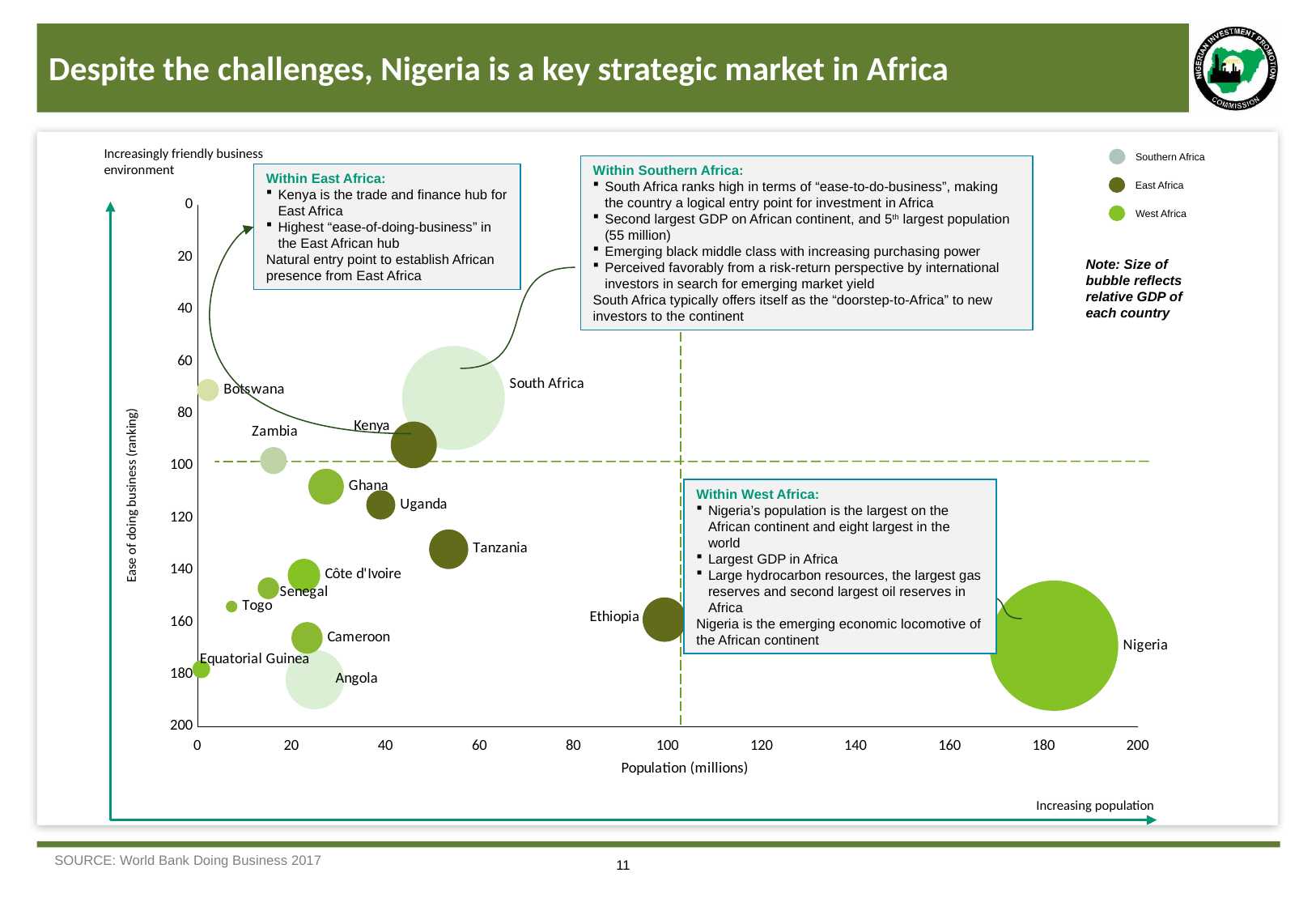
What does the size of each bubble represent according to the note? Relative GDP of each country What kind of chart is shown on the slide? Bubble chart Which country has the lowest (best) ease of doing business ranking on the chart? Botswana How many countries are plotted as bubbles on the chart? 15 What is the label of the x axis? Population (millions) Is the population value for Nigeria greater or less than 160 million? greater Is the population value for Togo greater or less than 20 million? less Is the ease of doing business ranking for Tanzania greater or less than 120? greater Which has the larger population, Nigeria or Ethiopia? Nigeria Which country has the largest population on the chart? Nigeria How many regions does the legend list? 3